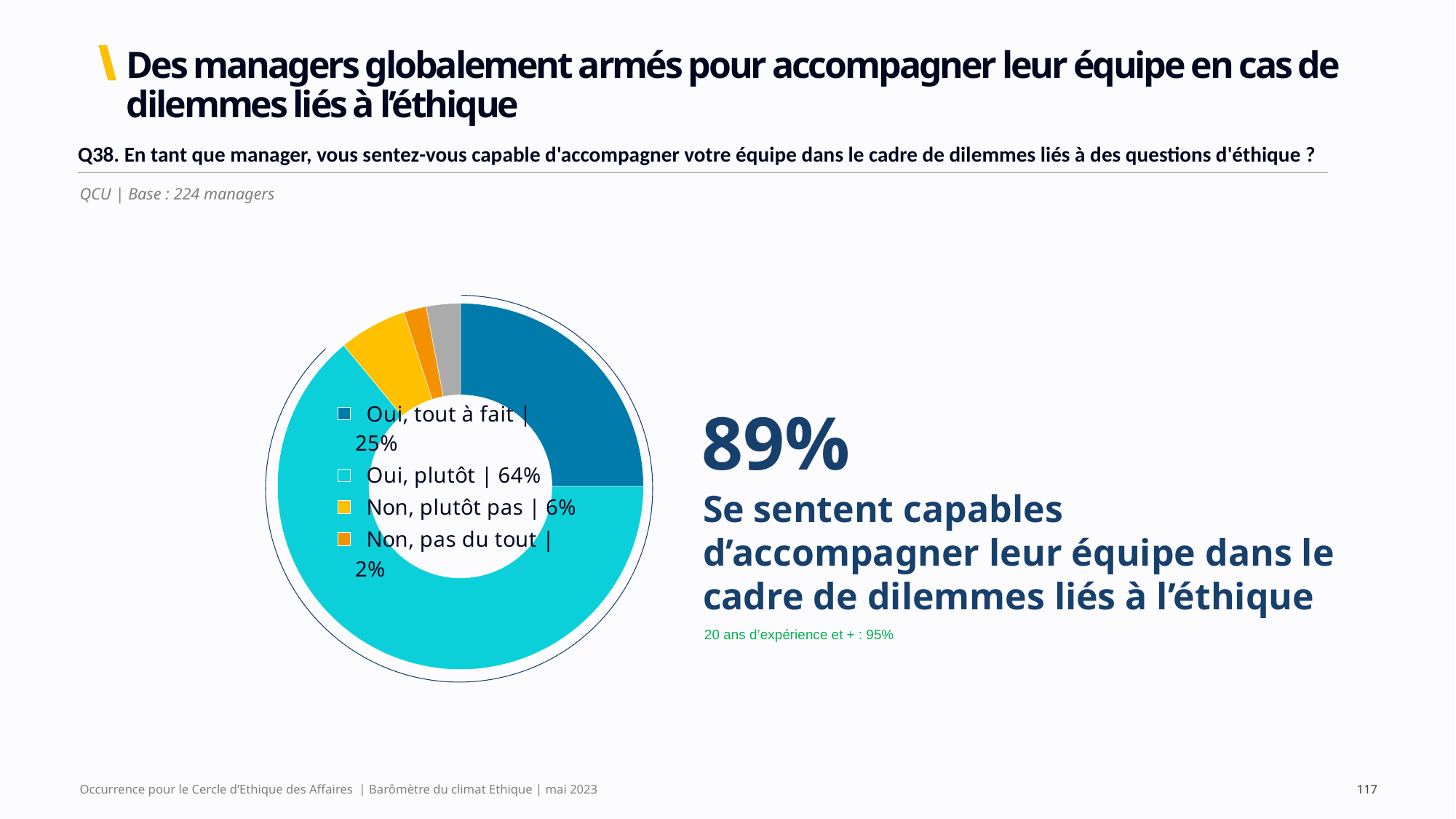
What percentage of managers answered "Oui, plutôt"? 64% Which response category has the largest share of the pie? Oui, plutôt What percentage of managers answered "Oui, tout à fait"? 25% What is the base (number of respondents) for the chart? 224 managers What percentage of managers answered "Non, pas du tout"? 2% What kind of chart is shown on the slide? Pie chart (donut) How many response categories does the legend list? 4 What is the combined share of the two "Oui" responses? 89% Which is larger: the share for "Non, plutôt pas" or the share for "Non, pas du tout"? Non, plutôt pas Which labelled response category has the smallest share of the pie? Non, pas du tout What is the difference in percentage points between "Oui, plutôt" and "Oui, tout à fait"? 39 percentage points What percentage of managers answered "Non, plutôt pas"? 6%